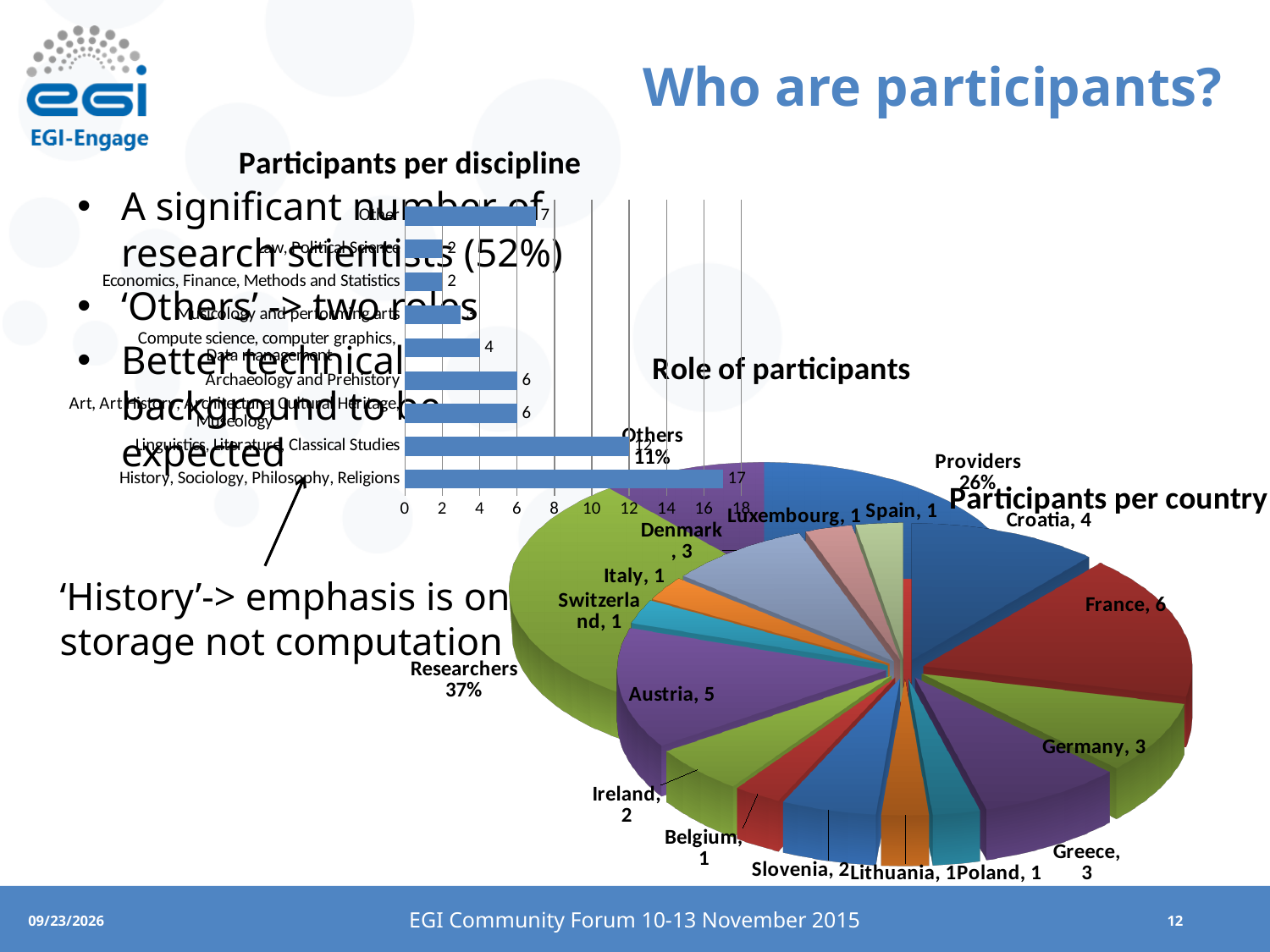
In the 'Role of participants' chart, which is larger: Others or Providers? Providers In the 'Participants per discipline' chart, which is larger: Other or Musicology and performing arts? Other In the 'Participants per country' chart, what is the difference between France and Germany? 3 In the 'Role of participants' chart, what share of participants are Providers? 26% In the 'Participants per discipline' chart, how many participants are in Linguistics, Literature, Classical Studies? 12 In the 'Participants per country' chart, how many participants are from France? 6 In the 'Participants per discipline' chart, what is the difference between History, Sociology, Philosophy, Religions and Archaeology and Prehistory? 11 In the 'Role of participants' chart, what share of participants are Researchers? 37% What kind of chart is 'Participants per discipline'? Bar chart In the 'Participants per discipline' chart, which discipline has the highest number of participants? History, Sociology, Philosophy, Religions In the 'Participants per country' chart, how many participants are from Austria? 5 In the 'Participants per discipline' chart, how many participants are in History, Sociology, Philosophy, Religions? 17